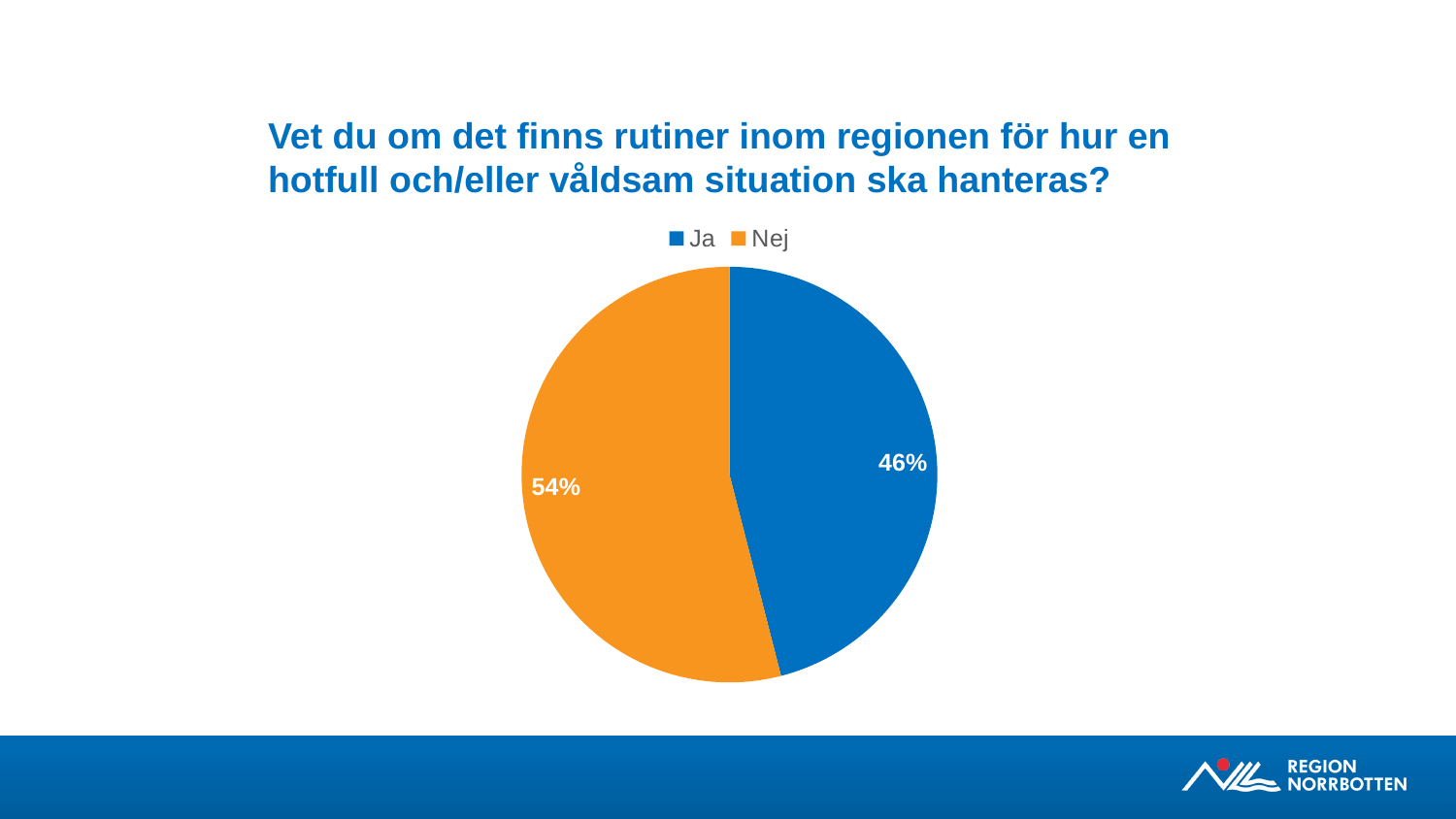
How many entries does the legend list? 2 Which slice is the smallest? Ja Which is larger, the share for "Ja" or the share for "Nej"? Nej What share of the pie does "Ja" represent? 46% What share of the pie does "Nej" represent? 54% What is the difference in percentage points between "Nej" and "Ja"? 8 What colour is the "Ja" slice? blue What colour is the "Nej" slice? orange Which slice is the largest? Nej What kind of chart is shown on the slide? pie chart How many slices does the pie chart have? 2